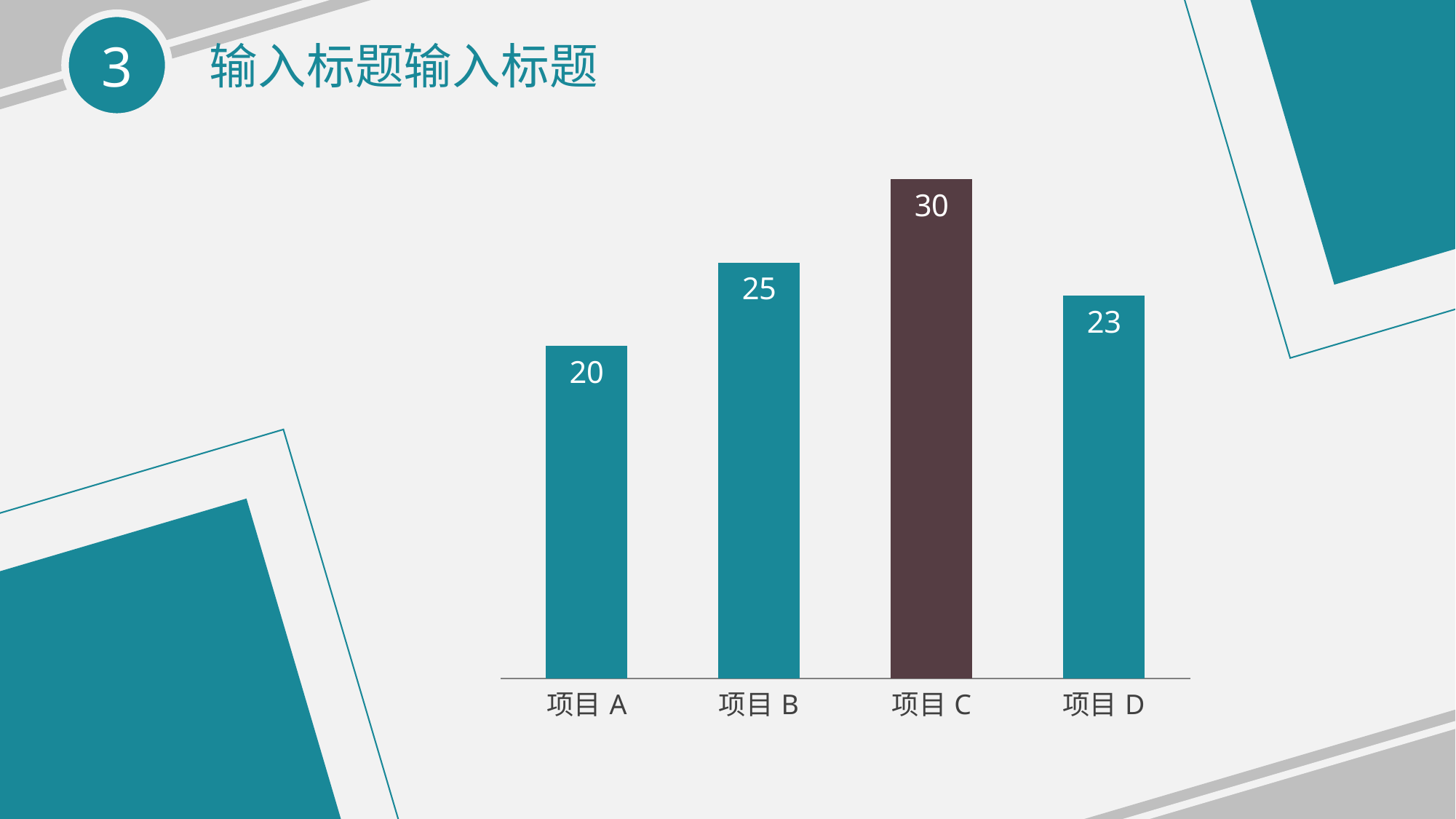
Which category has the highest value? 项目 C Which is larger, the value for 项目 B or the value for 项目 D? 项目 B What is the value for 项目 A? 20 What is the value for 项目 D? 23 What is the value for 项目 B? 25 How many categories are shown in the chart? 4 What is the value for 项目 C? 30 What is the difference between the values for 项目 C and 项目 A? 10 What kind of chart is shown on the slide? bar chart What is the difference between the values for 项目 B and 项目 D? 2 Which bar is shown in a different colour from the others? 项目 C Which category has the lowest value? 项目 A